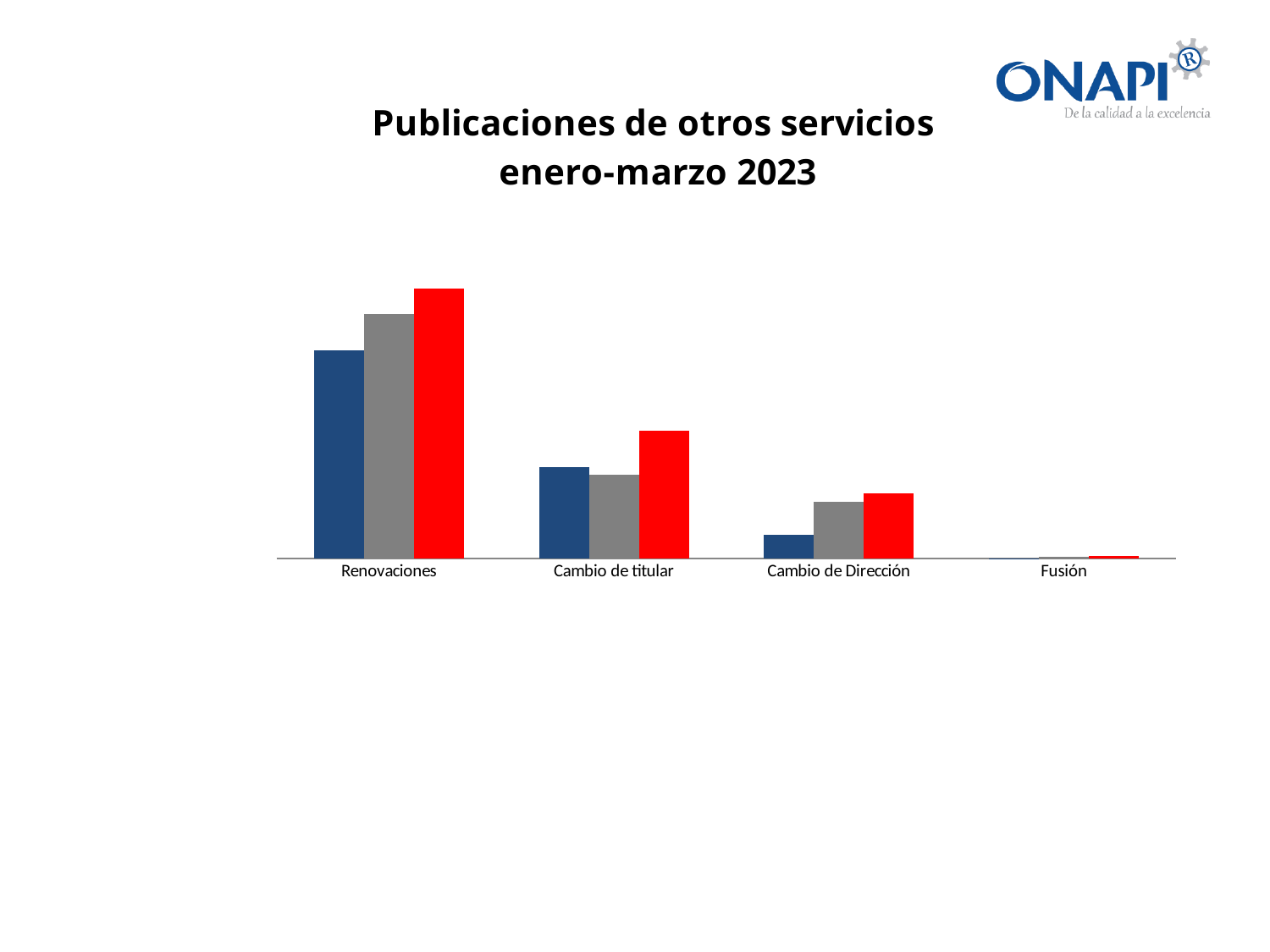
Do the blue bars rise or fall moving from left to right along the x axis? fall How many bars are plotted for each category in the chart? 3 Do the red bars rise or fall moving from Renovaciones to Fusión along the x axis? fall Which category has the tallest bars in the chart? Renovaciones What colours are the three bars in each category of the chart? blue, gray and red Which category has the shortest bars in the chart? Fusión How many categories are shown on the x axis of the chart? 4 Is the blue bar for Cambio de Dirección larger or smaller than the gray bar for Cambio de Dirección? smaller Is the blue bar for Cambio de titular larger or smaller than the blue bar for Renovaciones? smaller What is the title of the chart? Publicaciones de otros servicios enero-marzo 2023 What kind of chart is shown on the slide? bar chart Is the red bar for Renovaciones larger or smaller than the red bar for Cambio de titular? larger